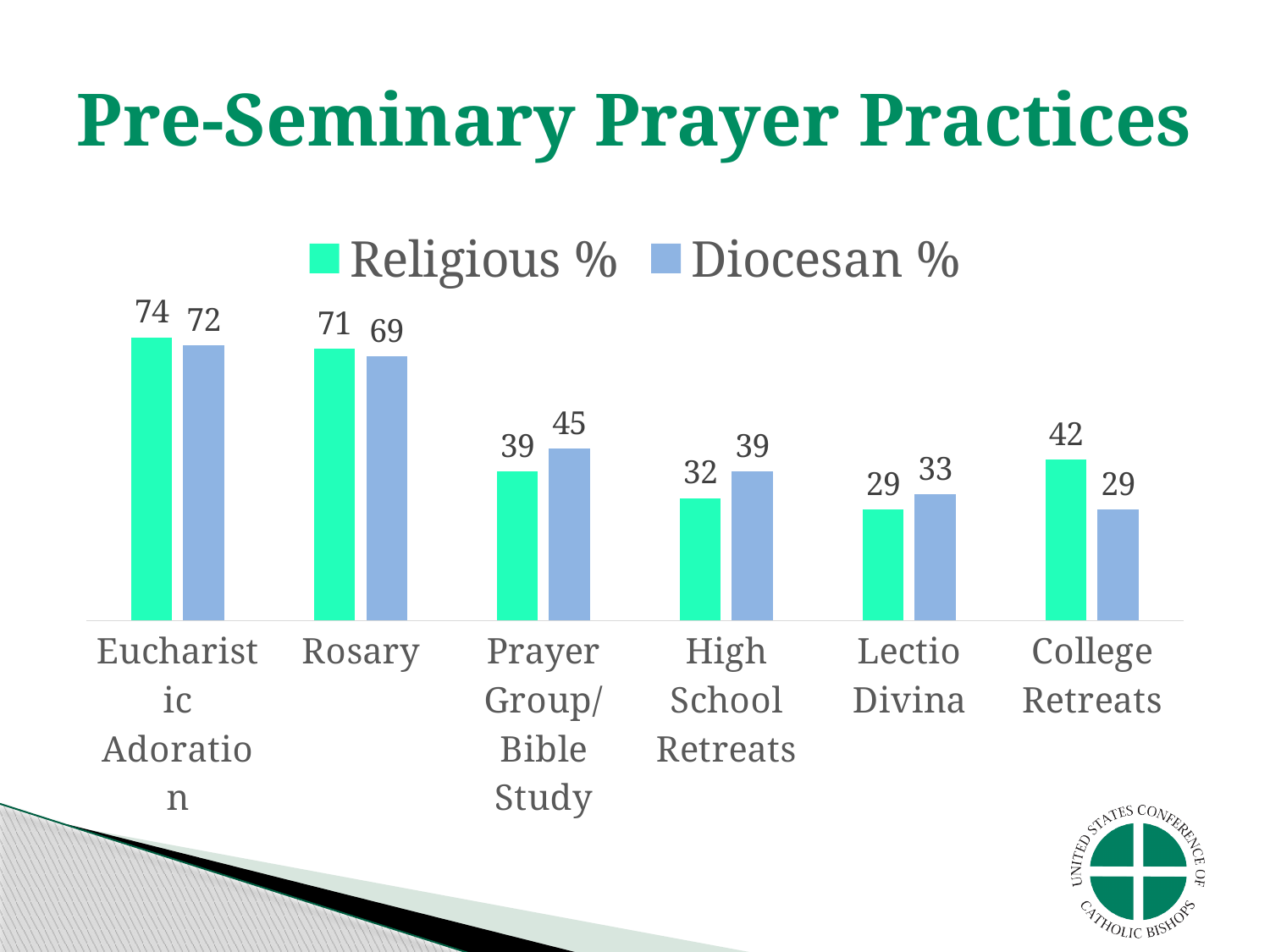
What is the Religious % value for Rosary? 71 Which category has the lowest Religious % value? Lectio Divina How many categories are shown on the x axis? 6 What kind of chart is shown on the slide? Bar chart How many series does the legend list? 2 What is the Diocesan % value for College Retreats? 29 Which category has the highest Religious % value? Eucharistic Adoration What is the Diocesan % value for Prayer Group/Bible Study? 45 What is the title of the slide? Pre-Seminary Prayer Practices Which colour represents the Diocesan % series? Blue For High School Retreats, which is larger: the Religious % or the Diocesan % value? Diocesan % What is the difference between the Religious % and Diocesan % values for College Retreats? 13